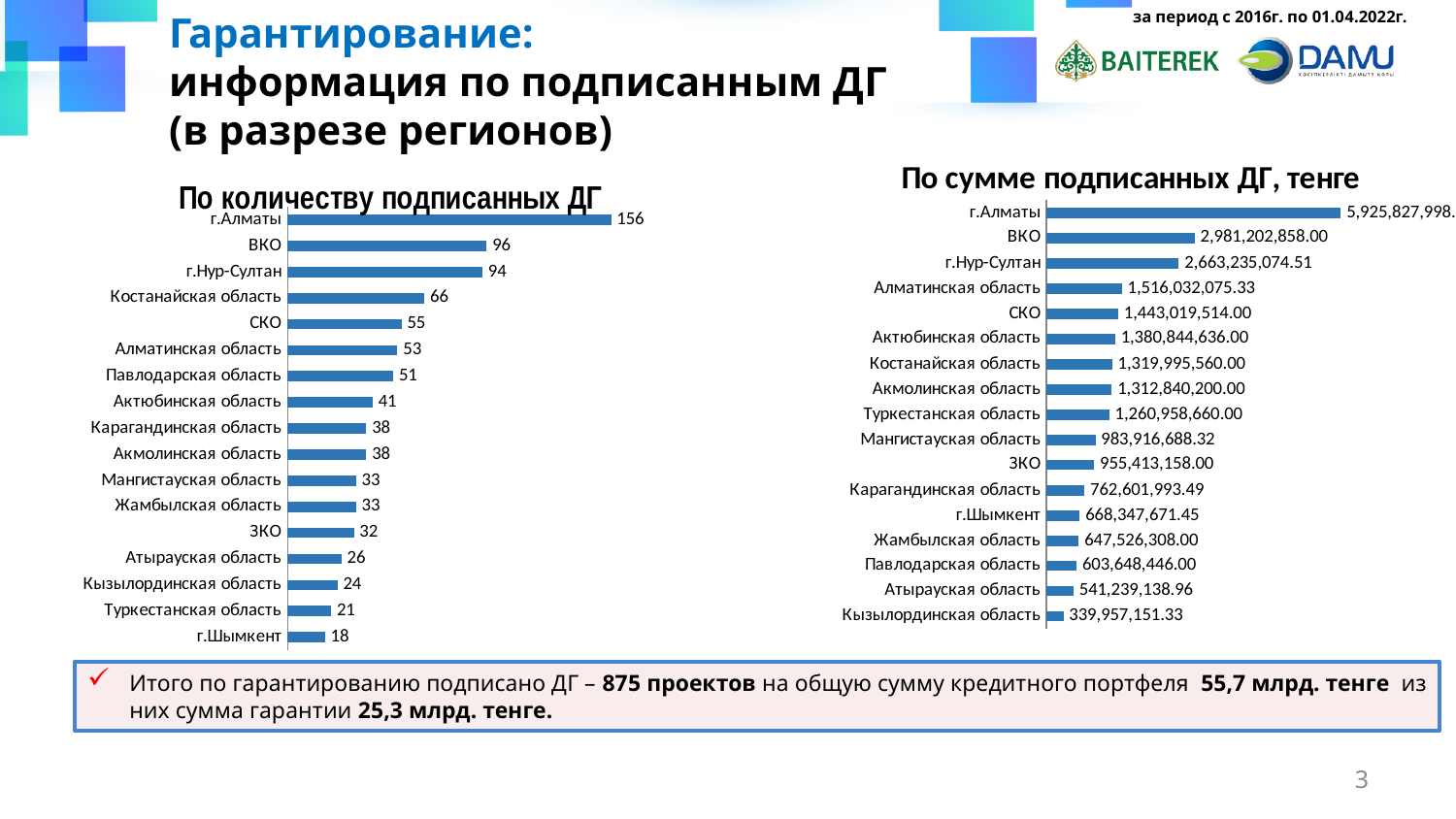
In the chart 'По количеству подписанных ДГ', which category has the highest value? г.Алматы In the chart 'По сумме подписанных ДГ, тенге', what is the value for Кызылординская область? 339,957,151.33 In the chart 'По количеству подписанных ДГ', what is the value for г.Нур-Султан? 94 In the chart 'По количеству подписанных ДГ', how many categories are shown? 17 In the chart 'По количеству подписанных ДГ', what is the value for Павлодарская область? 51 In the chart 'По количеству подписанных ДГ', what is the difference between the values for ВКО and Костанайская область? 30 In the chart 'По сумме подписанных ДГ, тенге', what is the value for ВКО? 2,981,202,858.00 In the chart 'По сумме подписанных ДГ, тенге', which is larger: the value for Актюбинская область or the value for Мангистауская область? Актюбинская область In the chart 'По количеству подписанных ДГ', which is larger: the value for СКО or the value for ЗКО? СКО In the chart 'По количеству подписанных ДГ', which category has the lowest value? г.Шымкент In the chart 'По сумме подписанных ДГ, тенге', which category has the lowest value? Кызылординская область What type of chart is 'По сумме подписанных ДГ, тенге'? Bar chart